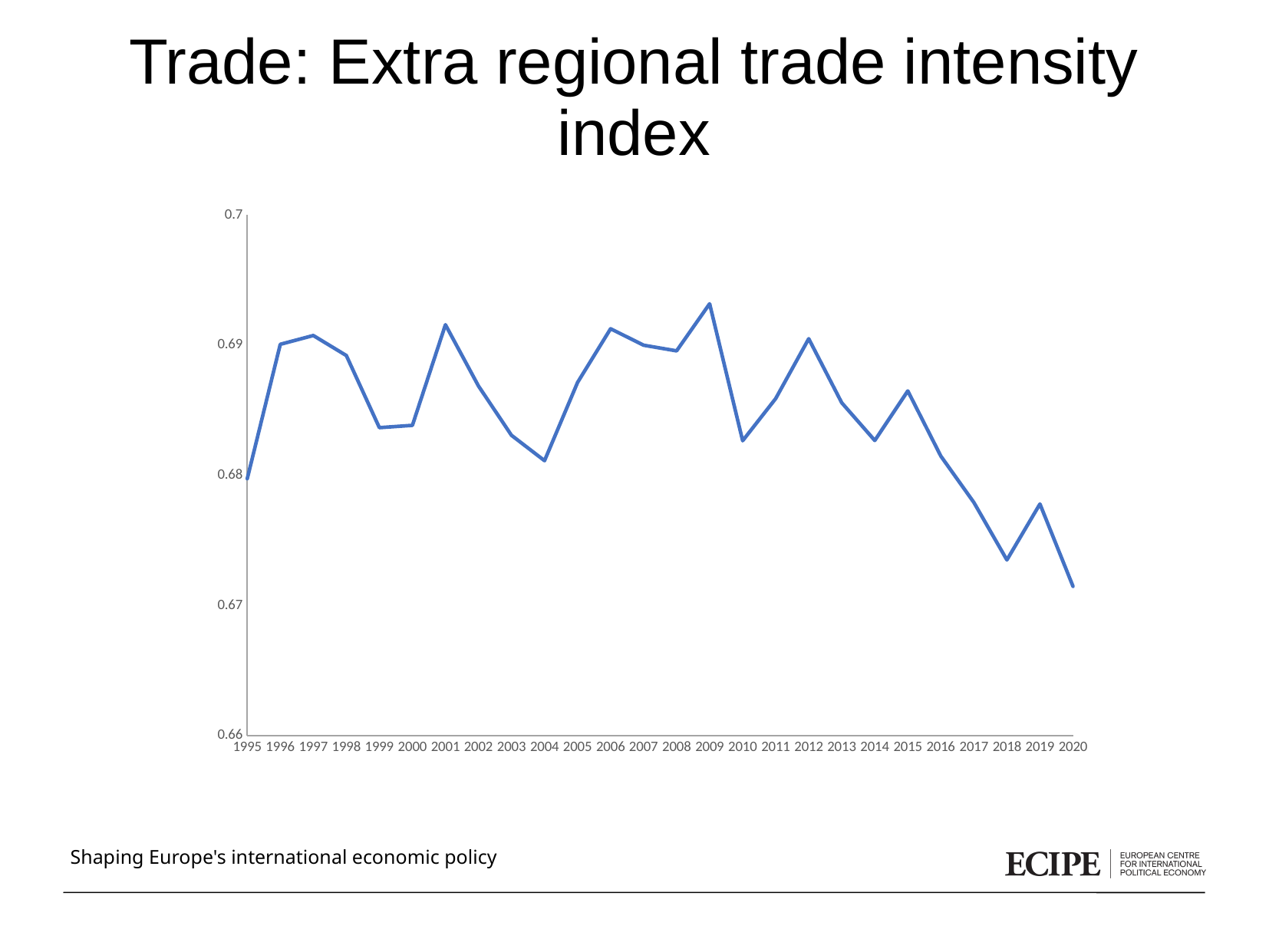
Is the value for 2015 greater or less than 0.69? less In which year does the extra regional trade intensity index reach its highest value? 2009 How many years are plotted along the x axis of the chart? 26 Is the value for 2020 greater or less than 0.68? less Is the value for 2018 greater or less than 0.68? less What is the title of the slide containing the chart? Trade: Extra regional trade intensity index In which year does the extra regional trade intensity index reach its lowest value? 2020 Between 2015 and 2018, does the index rise or fall? fall Which year has the larger value, 2001 or 2004? 2001 What kind of chart is shown on the slide? line chart Which year has the larger value, 2016 or 2018? 2016